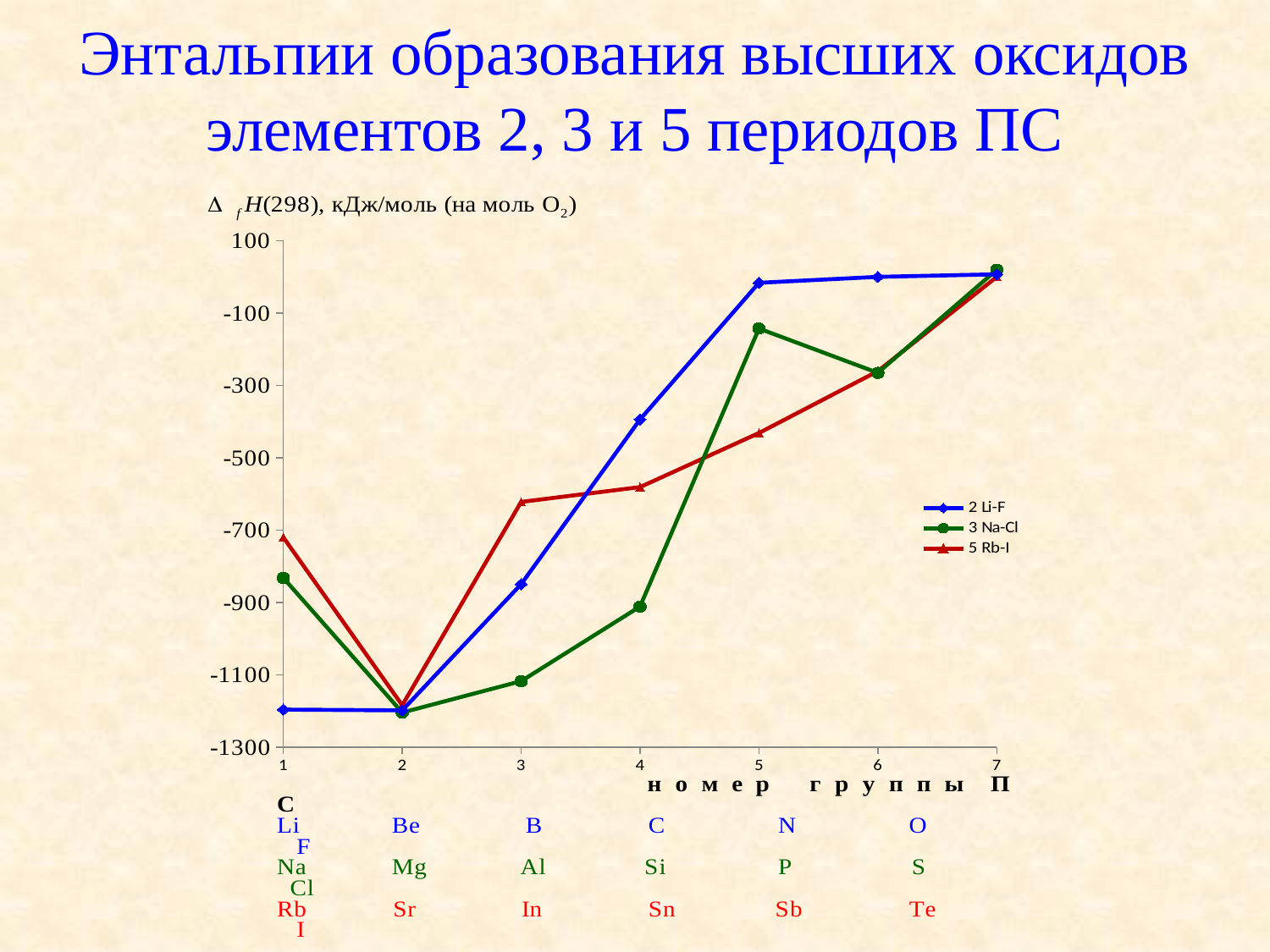
Is the value of the 3 Na-Cl series at group 5 greater or less than -300? greater Which series is drawn in red? 5 Rb-I What quantity is plotted on the y axis, according to the label above the chart? ΔfH(298), кДж/моль (на моль O2) How many series does the legend list? 3 Is the value of the 2 Li-F series at group 4 greater or less than -300? less What kind of chart is shown on the slide? line chart How many group numbers are plotted along the x axis? 7 Is the value of the 2 Li-F series at group 3 greater or less than -700? less At which group number does the 3 Na-Cl series reach its lowest value? 2 At group 5, which series has the higher value: 2 Li-F or 3 Na-Cl? 2 Li-F At group 1, which series has the higher value: 5 Rb-I or 3 Na-Cl? 5 Rb-I